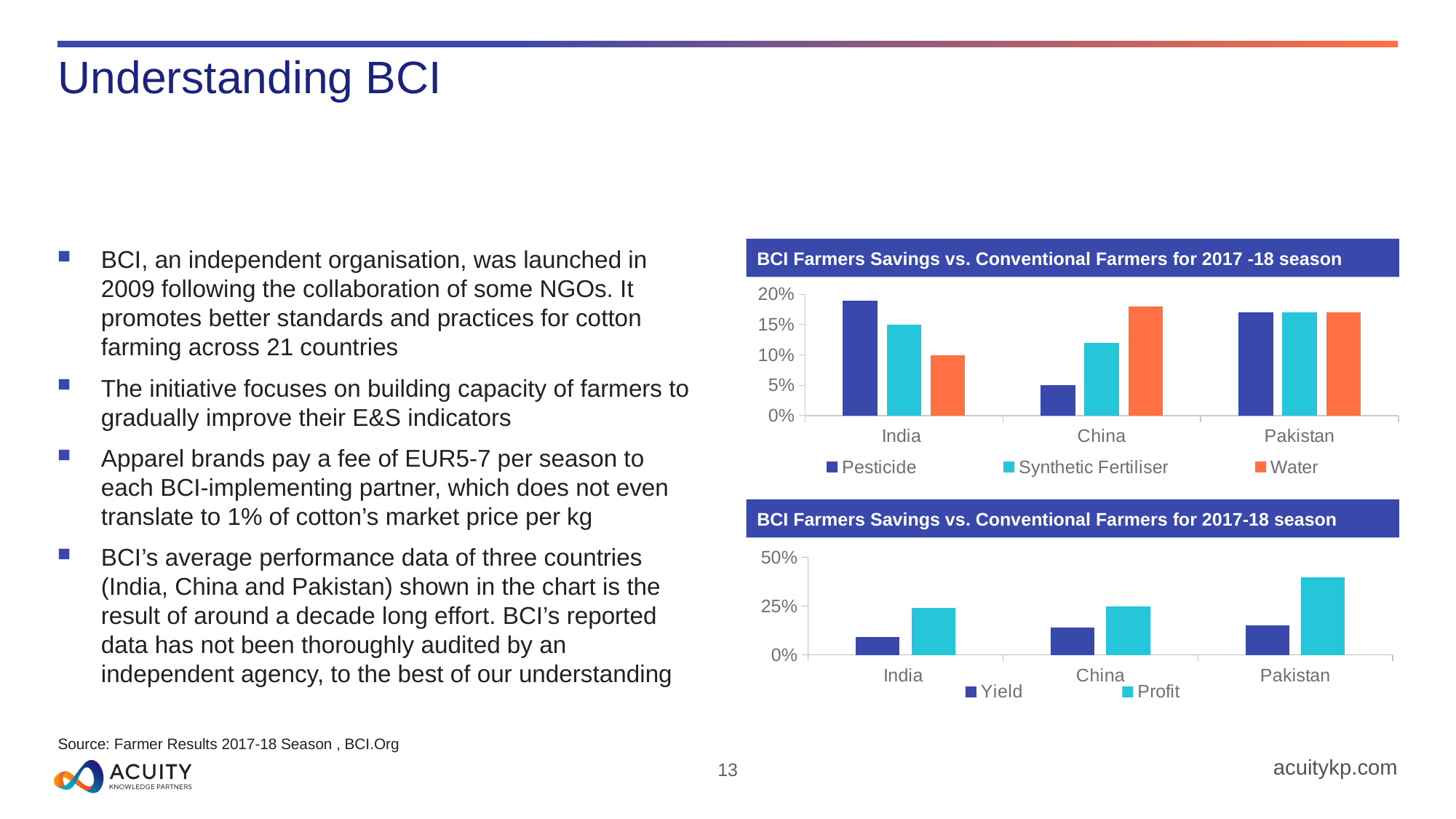
In the bottom chart, which country has the highest Profit value? Pakistan How many series does the legend of the top chart list? 3 In the top chart, which is larger for China: Pesticide or Water? Water How many countries are shown on the x axis of the bottom chart? 3 What type of chart is the top chart on the slide? bar chart In the top chart, which country has the lowest Water savings? India In the top chart, is the Pesticide value for India greater or less than 15%? greater In the top chart, which country has the highest Pesticide savings? India In the top chart, is the Synthetic Fertiliser value for China greater or less than 15%? less In the bottom chart, is the Profit value for Pakistan greater or less than 25%? greater In the top chart, which country has the lowest Pesticide savings? China Which two series does the legend of the bottom chart list? Yield and Profit